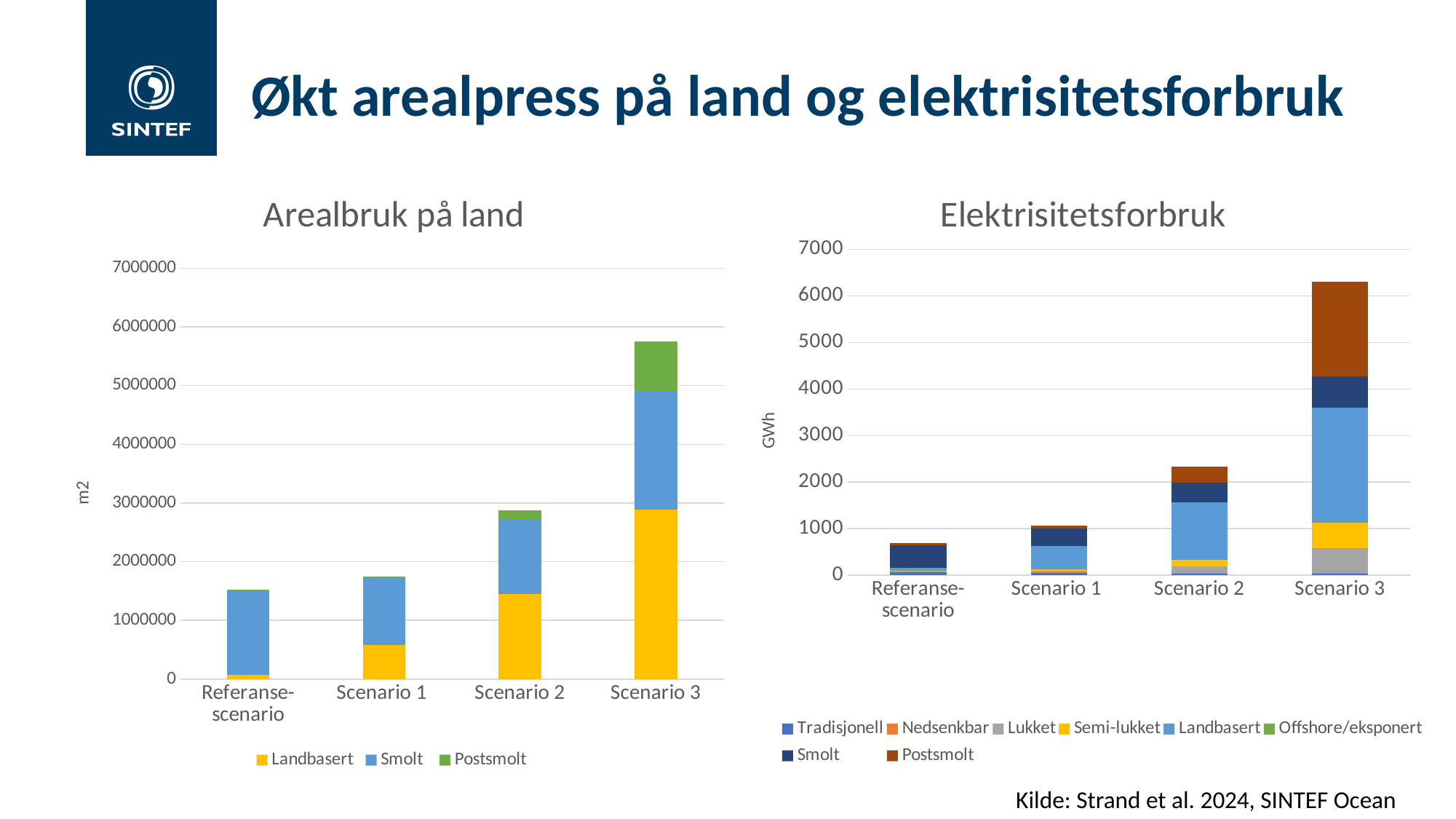
In the 'Arealbruk på land' chart, which scenario has the highest total land area use? Scenario 3 In the 'Arealbruk på land' chart, is the total value for Referanse-scenario greater or less than 2000000? less In the 'Arealbruk på land' chart, which scenario has the lowest total land area use? Referanse-scenario How many series does the legend of the 'Arealbruk på land' chart list? 3 In the 'Elektrisitetsforbruk' chart, is the total value for Referanse-scenario greater or less than 1000? less In the 'Arealbruk på land' chart, is the total value for Scenario 3 greater or less than 5000000? greater How many series does the legend of the 'Elektrisitetsforbruk' chart list? 8 What unit is shown on the y axis of the 'Elektrisitetsforbruk' chart? GWh What kind of chart is the 'Arealbruk på land' chart? stacked bar chart In the 'Elektrisitetsforbruk' chart, do the total values rise or fall from Referanse-scenario to Scenario 3? rise In the 'Elektrisitetsforbruk' chart, how many scenarios are shown on the x axis? 4